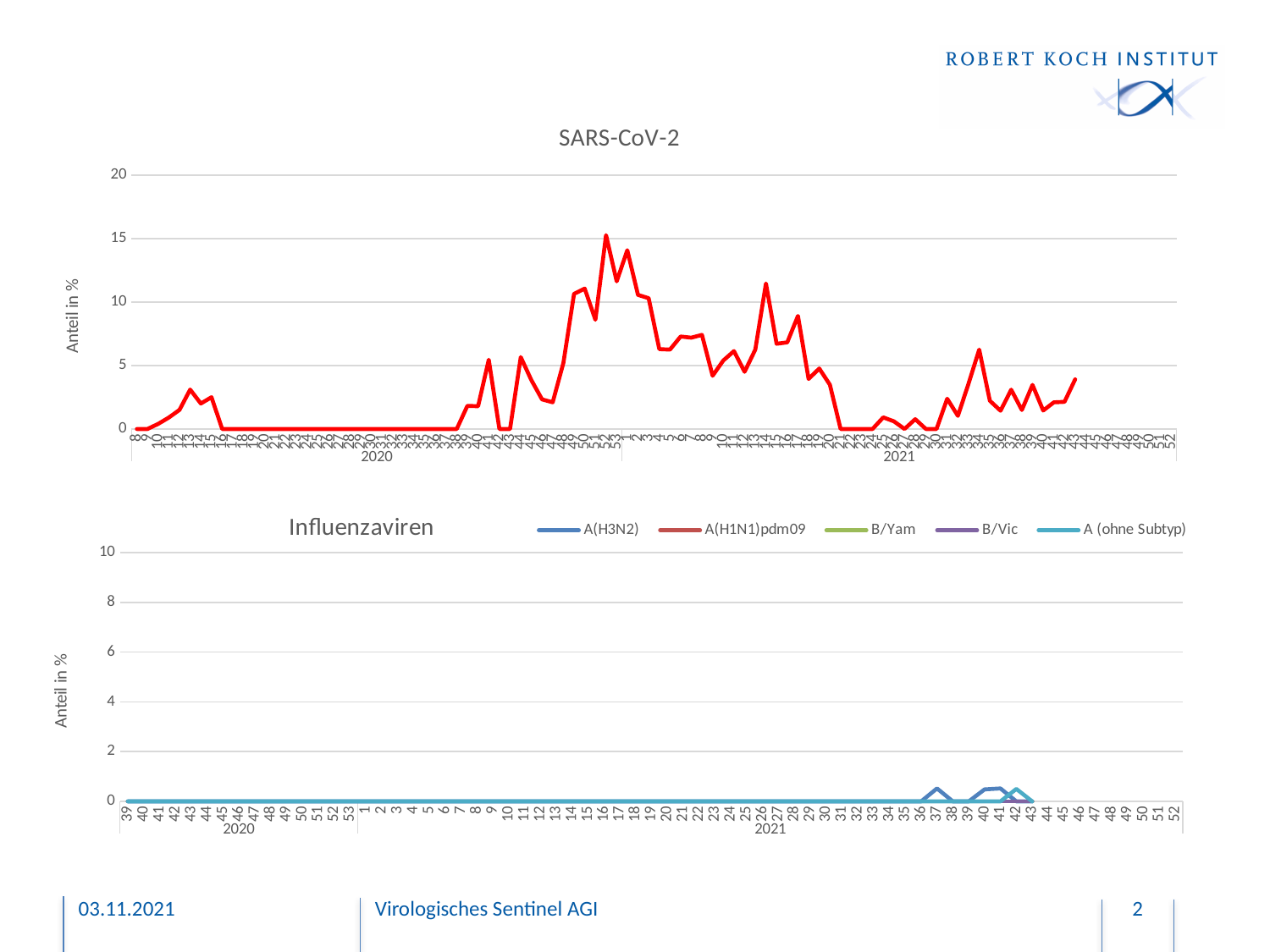
In the SARS-CoV-2 chart, is the value at week 20 of 2020 greater or less than 5? less In the Influenzaviren chart, which series is listed first in the legend? A(H3N2) In the SARS-CoV-2 chart, is the value at week 53 of 2020 greater or less than 10? greater In the SARS-CoV-2 chart, do the values rise or fall between week 18 of 2021 and week 22 of 2021? fall How many series does the legend of the Influenzaviren chart list? 5 What is the highest value shown on the y-axis of the Influenzaviren chart? 10 What kind of chart is the Influenzaviren chart at the bottom of the slide? line chart In the SARS-CoV-2 chart, is the highest value of the line greater or less than 10? greater What is the y-axis label of the SARS-CoV-2 chart? Anteil in % What kind of chart is the SARS-CoV-2 chart at the top of the slide? line chart In the SARS-CoV-2 chart, do the values rise or fall between week 39 of 2020 and week 53 of 2020? rise